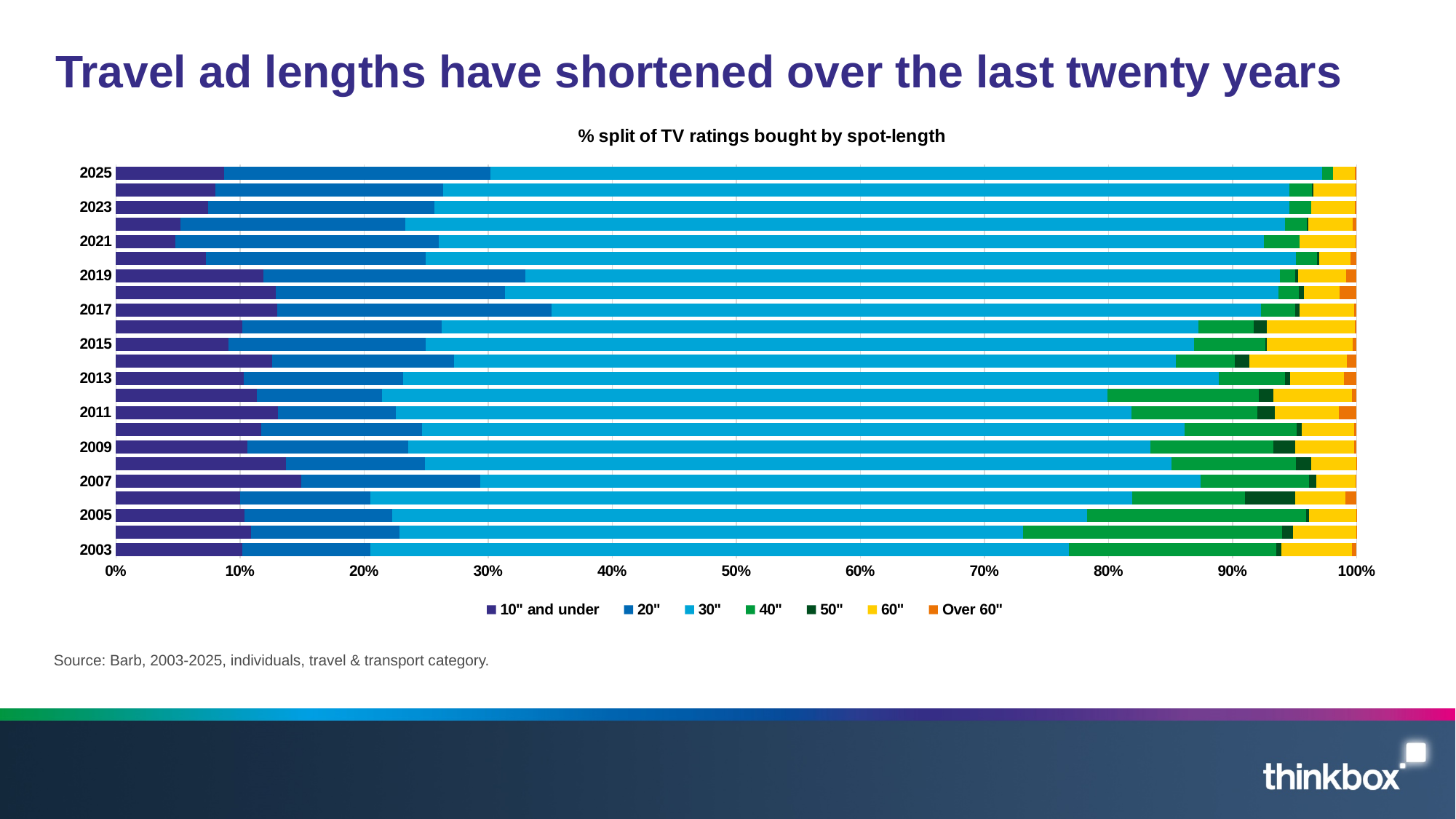
Is the 10" and under share for 2021 greater or less than 10%? less Which year has the smallest 10" and under share? 2021 Which year has a larger 40" share, 2003 or 2025? 2003 How many years (bars) are plotted in the chart? 23 What kind of chart is shown on the slide? Stacked bar chart Which year has a larger 10" and under share, 2007 or 2021? 2007 Is the 10" and under share for 2007 greater or less than 10%? greater Does the 40" share generally rise or fall from 2003 to 2025? fall Is the 10" and under share for 2017 greater or less than 10%? greater What is the title of the chart? % split of TV ratings bought by spot-length Which legend entry is shown in yellow? 60" How many series does the legend list? 7